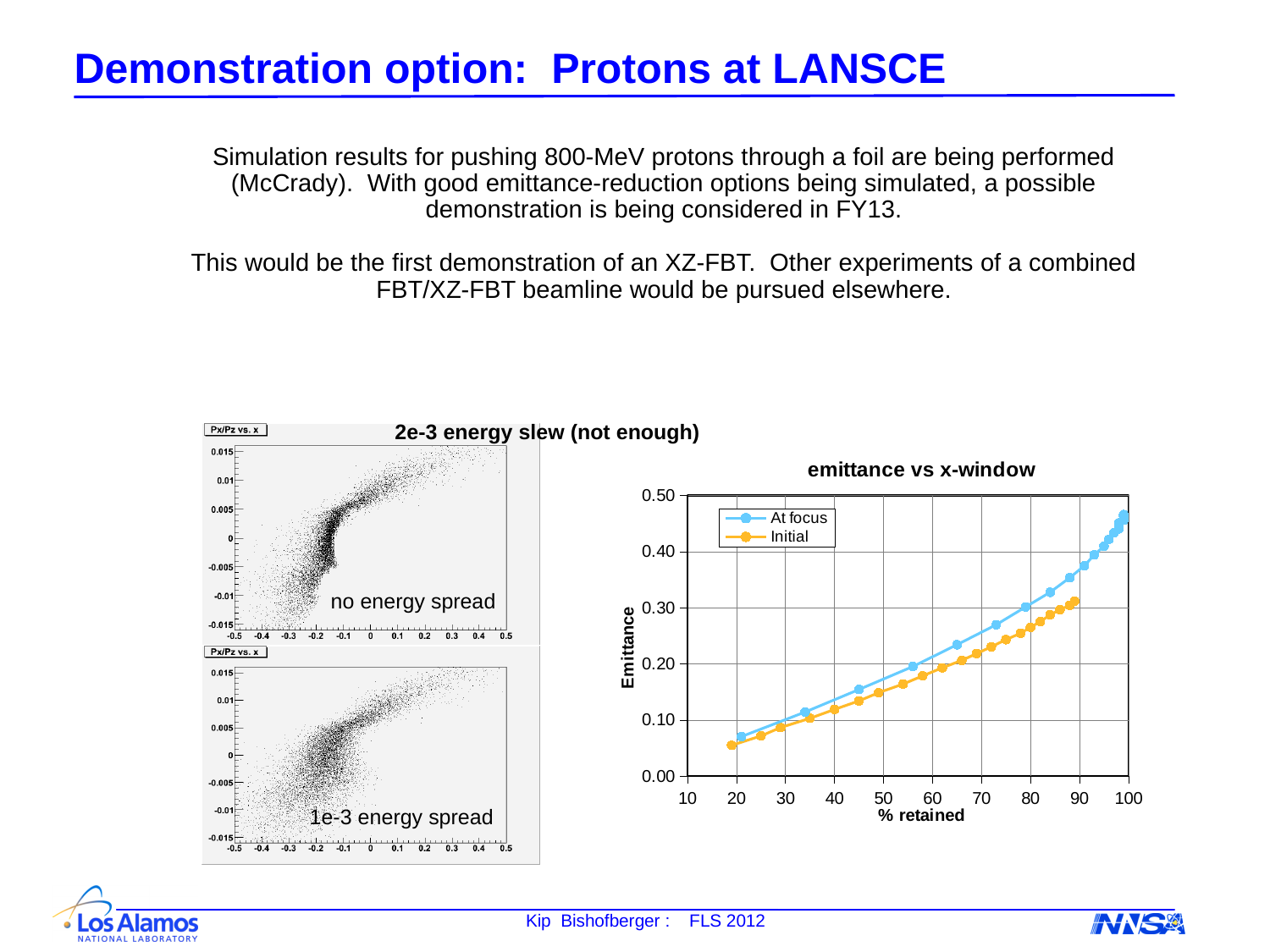
In the "emittance vs x-window" chart, is the Initial value at 80% retained greater or less than 0.30? less What kind of chart is the "emittance vs x-window" chart? line chart How many series does the legend of the "emittance vs x-window" chart list? 2 In the "emittance vs x-window" chart, which series reaches the highest emittance value? At focus What is the y-axis label of the "emittance vs x-window" chart? Emittance In the "emittance vs x-window" chart, is the At focus value at 100% retained greater or less than 0.40? greater What is the x-axis label of the "emittance vs x-window" chart? % retained In the "emittance vs x-window" chart, does emittance rise or fall as % retained increases? rise In the "emittance vs x-window" chart, is the At focus value at 90% retained greater or less than 0.30? greater In the "emittance vs x-window" chart, which series has the higher emittance at 80% retained, At focus or Initial? At focus What kind of chart are the two "Px/Pz vs. x" plots on the left of the slide? scatter plot